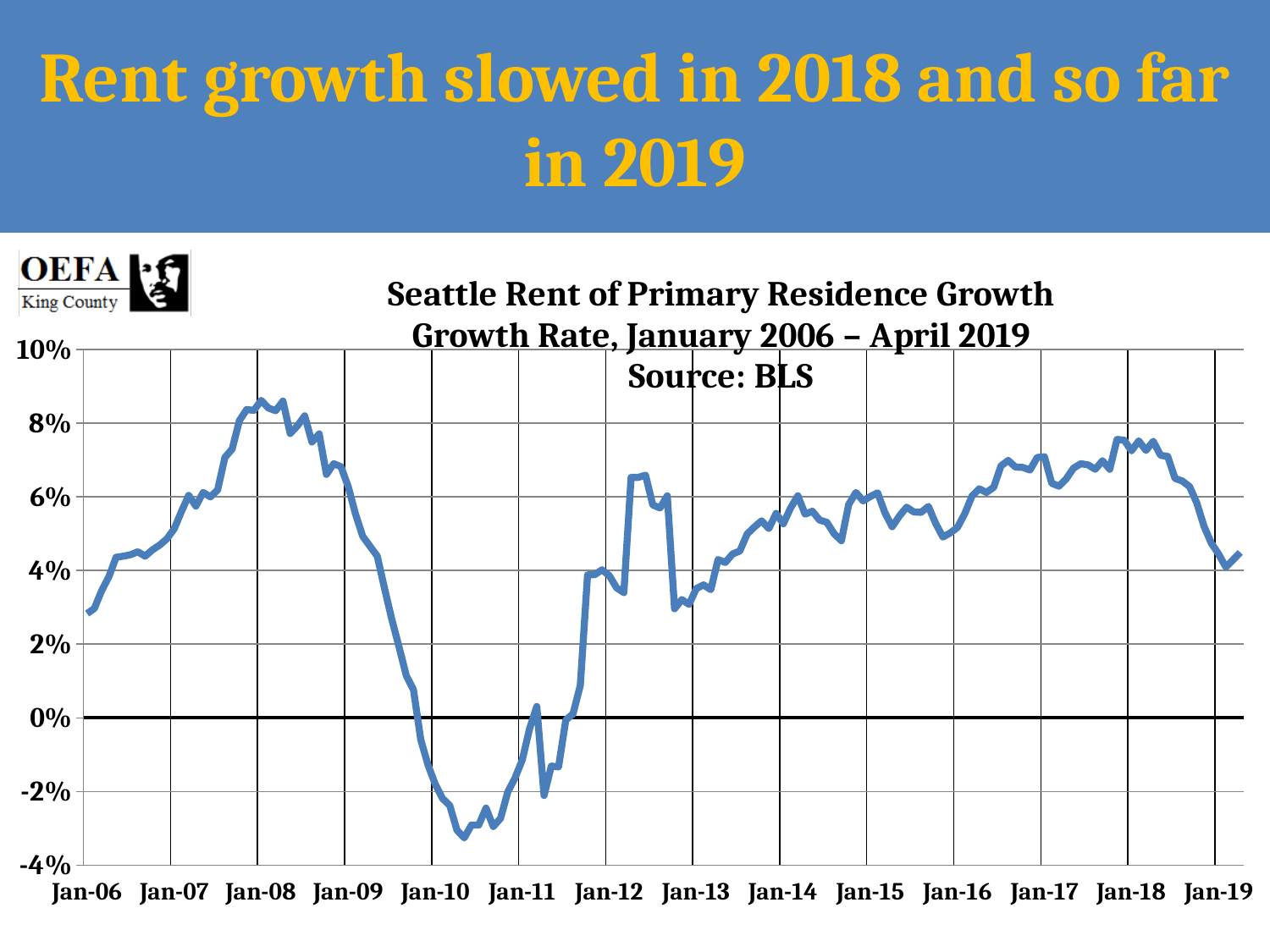
What period does the chart title say the growth rate covers? January 2006 – April 2019 Is the value at Jan-16 greater or less than 6%? less Is the value at Jan-19 greater or less than 6%? less What is the source cited for the chart? BLS How many year labels (Jan-06 through Jan-19) are shown on the x axis? 14 In which year does the line reach its lowest value? 2010 In which year does the line reach its highest value? 2008 What kind of chart is shown on the slide? line chart Does the growth rate rise or fall between Jan-18 and Jan-19? fall Is the value at Jan-06 greater or less than 4%? less